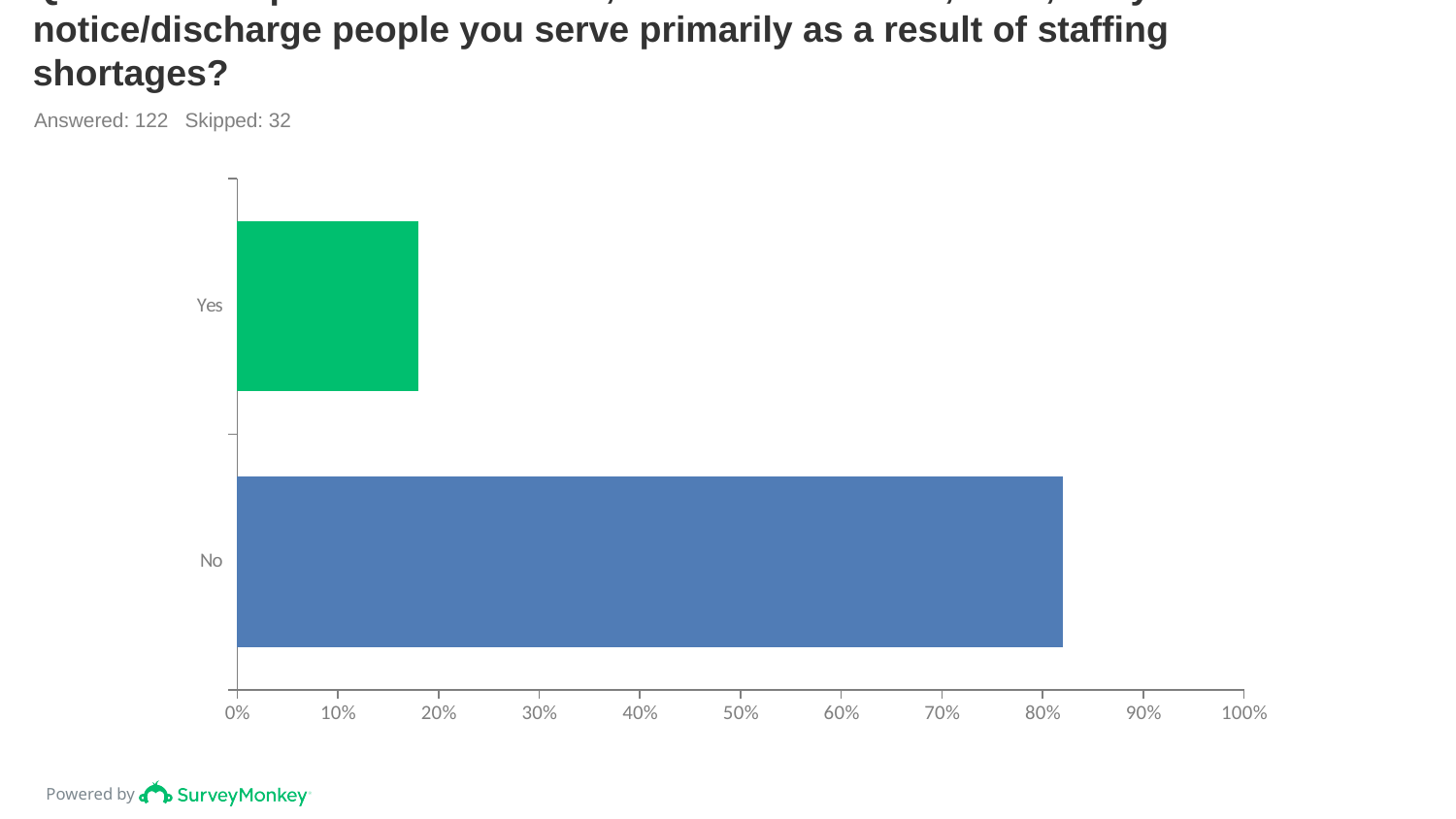
Which category has the highest value? No Which category has the lowest value? Yes Is the value for No greater or less than 90%? less Is the value for Yes greater or less than 20%? less What kind of chart is shown on the slide? bar chart Which is larger, the value for Yes or the value for No? No Is the value for No greater or less than 80%? greater How many respondents answered the question according to the slide? 122 How many categories are plotted in the chart? 2 What is the maximum value shown on the x axis? 100%